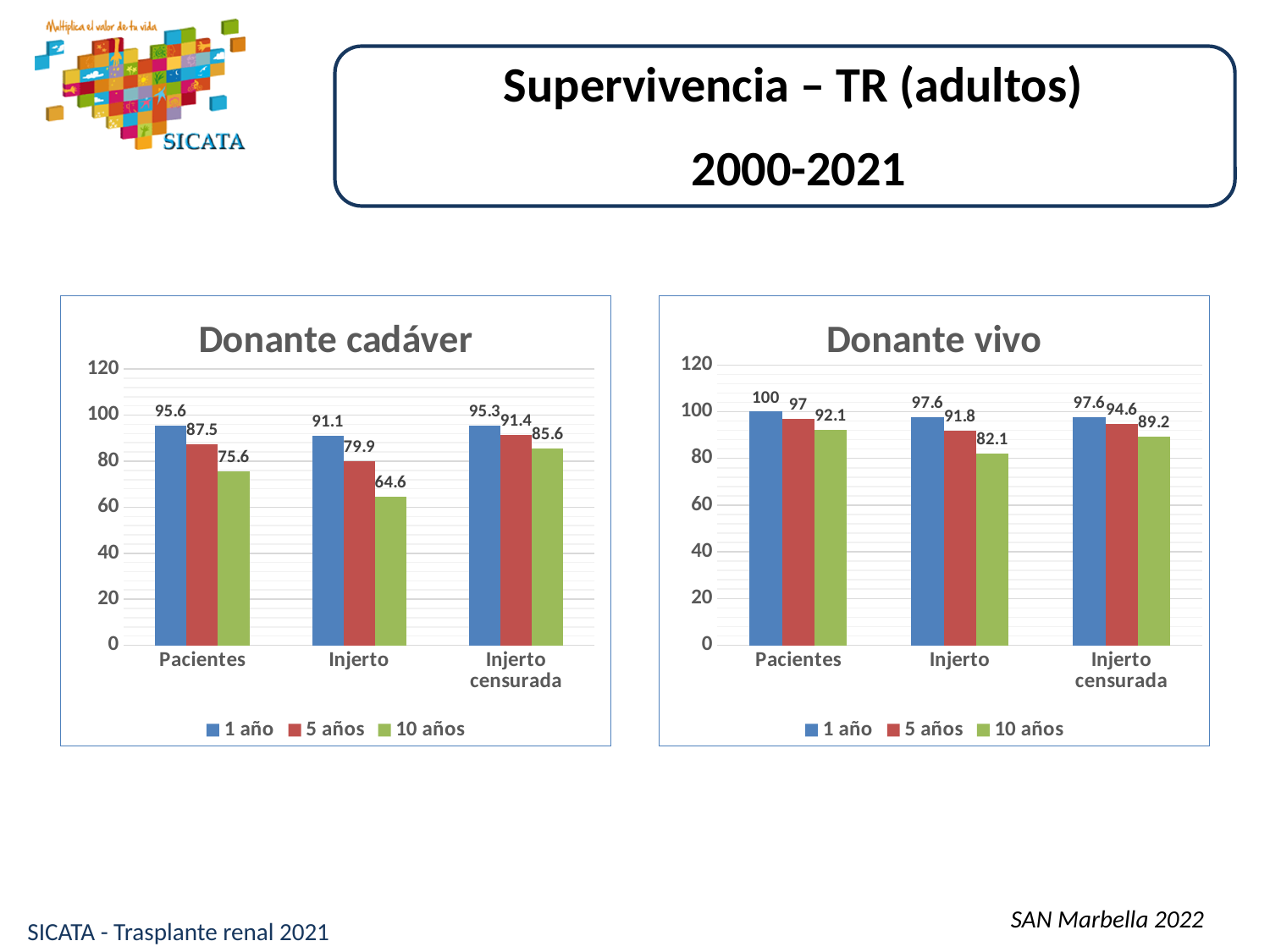
Which is larger: the 10 años value for Injerto in the 'Donante cadáver' chart or in the 'Donante vivo' chart? Donante vivo What kind of chart is the 'Donante cadáver' chart? Bar chart In the 'Donante cadáver' chart, what is the 10 años value for Injerto? 64.6 How many series does the legend of the 'Donante vivo' chart list? 3 In the 'Donante vivo' chart, what is the 10 años value for Injerto? 82.1 In the 'Donante vivo' chart, which category has the highest 5 años value? Pacientes In the 'Donante vivo' chart, what is the difference between the 1 año and 5 años values for Injerto? 5.8 In the 'Donante vivo' chart, what is the 1 año value for Pacientes? 100 In the 'Donante cadáver' chart, what is the difference between the 1 año and 10 años values for Pacientes? 20 In the 'Donante cadáver' chart, which category has the lowest 10 años value? Injerto How many categories are shown on the x axis of the 'Donante cadáver' chart? 3 In the 'Donante cadáver' chart, what is the 5 años value for Injerto censurada? 91.4